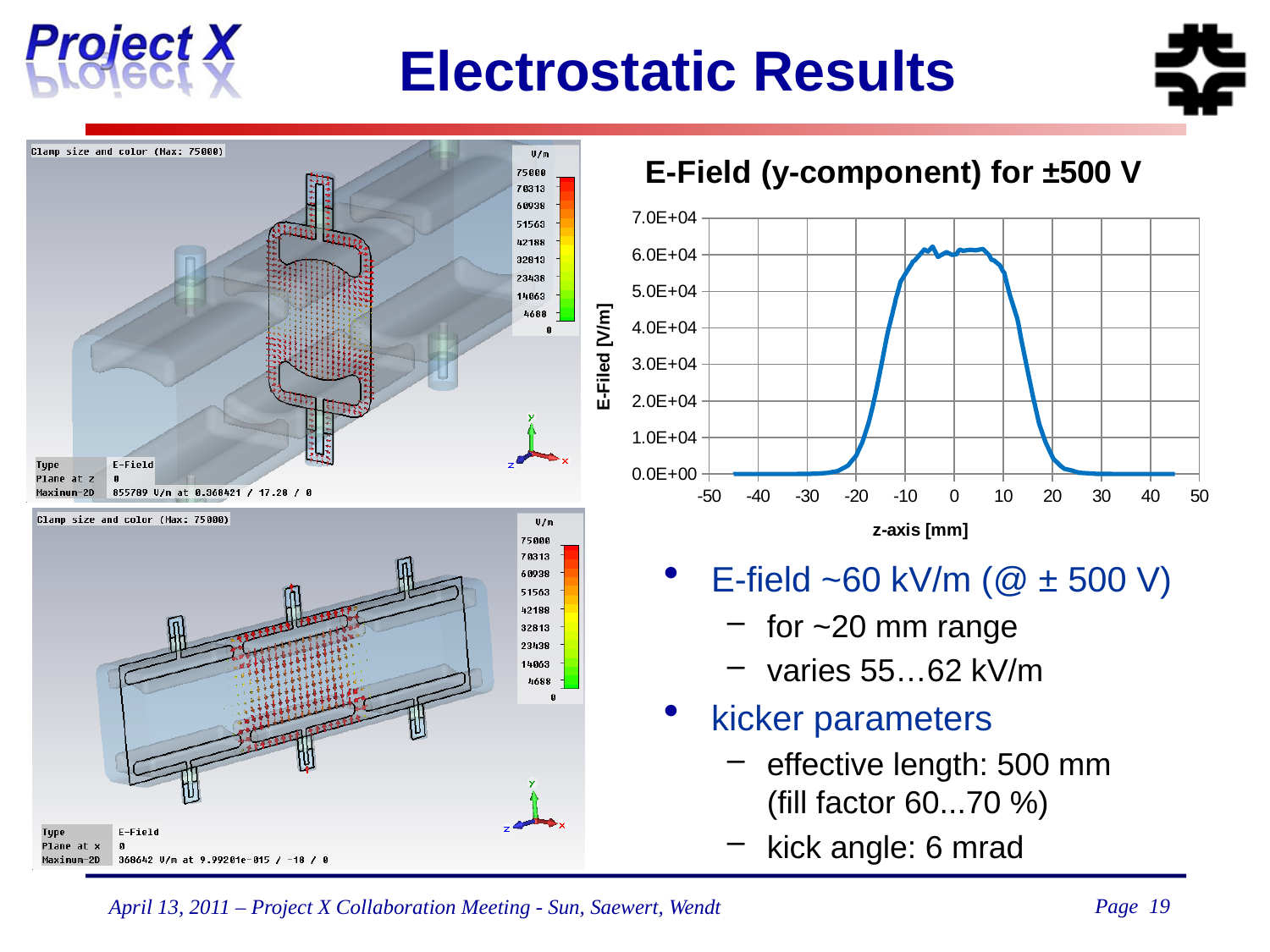
Is the maximum value of the E-field curve greater or less than 7.0E+04? less Does the E-field value rise or fall as z goes from 0 mm to 20 mm? fall What is the label of the x axis of the chart? z-axis [mm] Is the value of the E-field at z = -30 mm greater or less than 1.0E+04? less What kind of chart is shown on the slide? line chart How many tick labels are shown on the x axis of the chart? 11 Is the value of the E-field at z = -10 mm greater or less than 5.0E+04? greater Does the E-field value rise or fall as z goes from -20 mm to 0 mm? rise What is the title of the chart on the slide? E-Field (y-component) for ±500 V